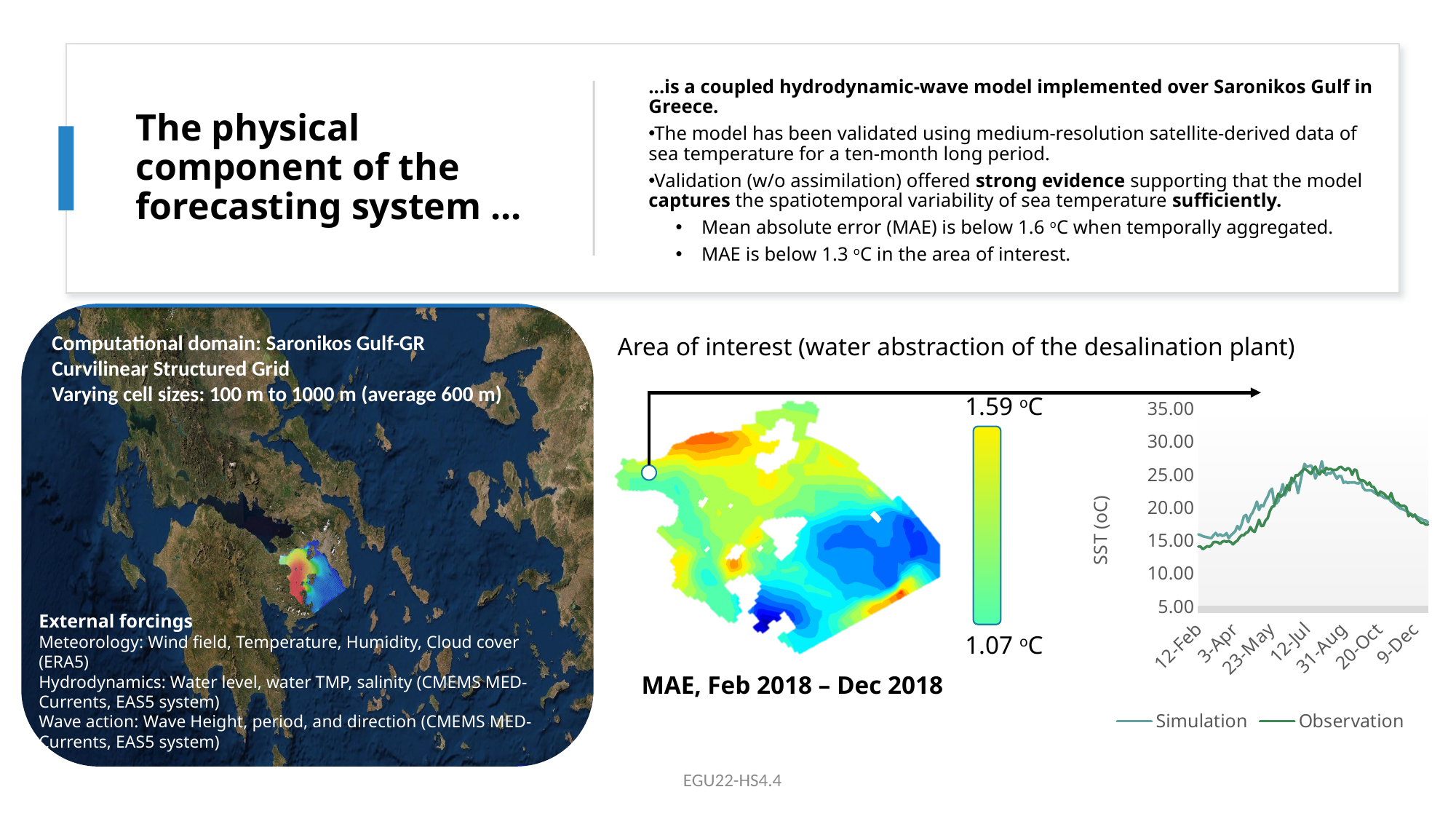
What kind of chart is the SST chart on the right of the slide? line chart What is the maximum value shown on the colour bar of the MAE map (Feb 2018 – Dec 2018)? 1.59 oC In the SST line chart, do the values rise or fall between 12-Feb and 12-Jul? rise What is the label on the y axis of the SST line chart? SST (oC) In the SST line chart, is the Observation value at 9-Dec greater or less than 10.00? greater How many series does the legend of the SST line chart list? 2 How many date labels are shown on the x axis of the SST line chart? 7 In the SST line chart, is the Observation value at 12-Jul greater or less than 20.00? greater In the SST line chart, is the Simulation value at 12-Feb greater or less than 20.00? less In the SST line chart, do the values rise or fall between 31-Aug and 9-Dec? fall What are the two series named in the legend of the SST line chart? Simulation and Observation